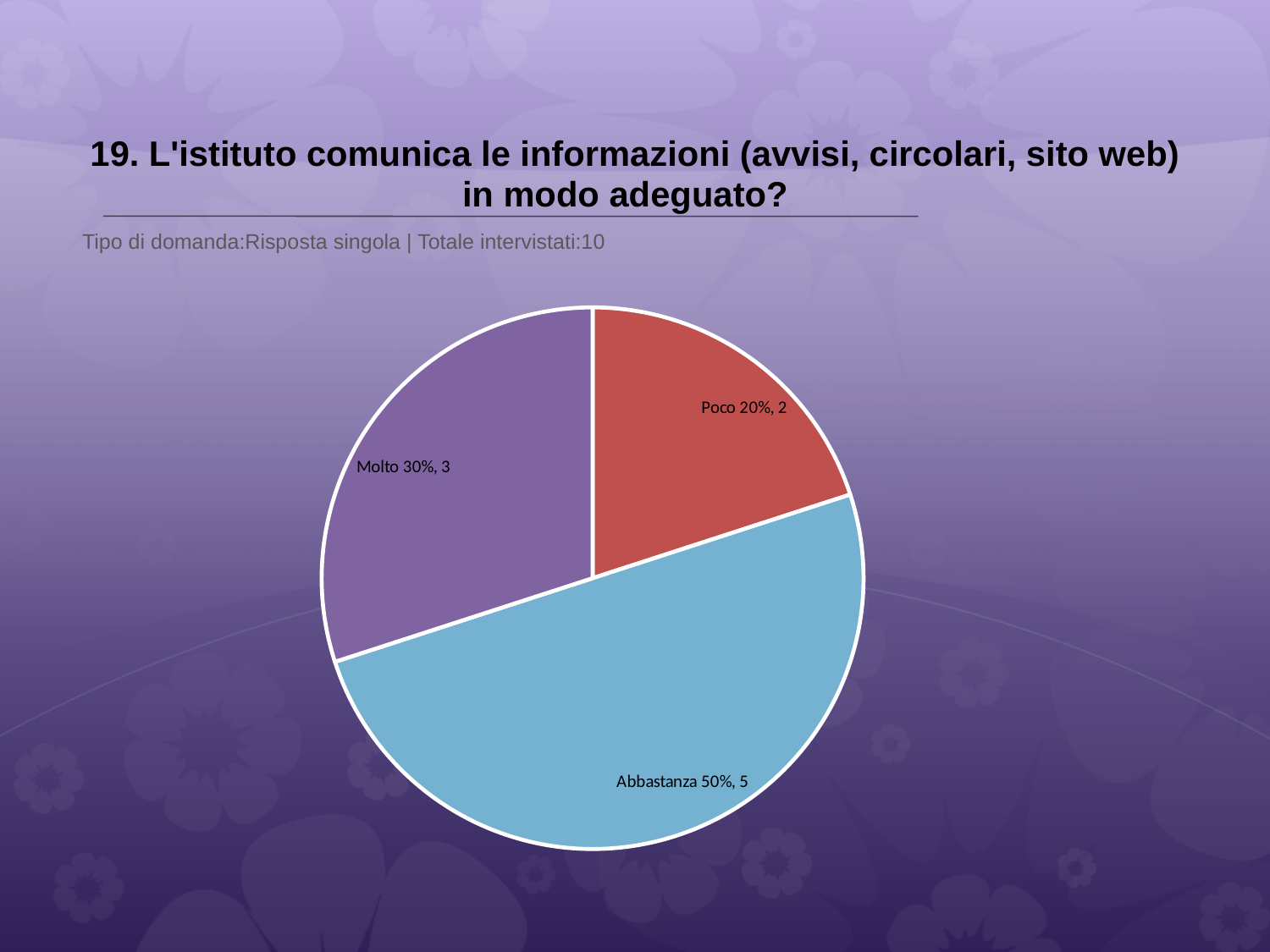
How many respondents answered 'Molto'? 3 How many slices does the pie chart have? 3 How many respondents answered 'Abbastanza'? 5 Which response category has the smallest slice? Poco Which response category has the largest slice? Abbastanza Which has more respondents, 'Molto' or 'Poco'? Molto What percentage share does the 'Molto' slice have? 30% What percentage share does the 'Abbastanza' slice have? 50% What kind of chart is shown on the slide? pie chart What is the difference in number of respondents between 'Abbastanza' and 'Poco'? 3 How many respondents answered 'Poco'? 2 What percentage share does the 'Poco' slice have? 20%